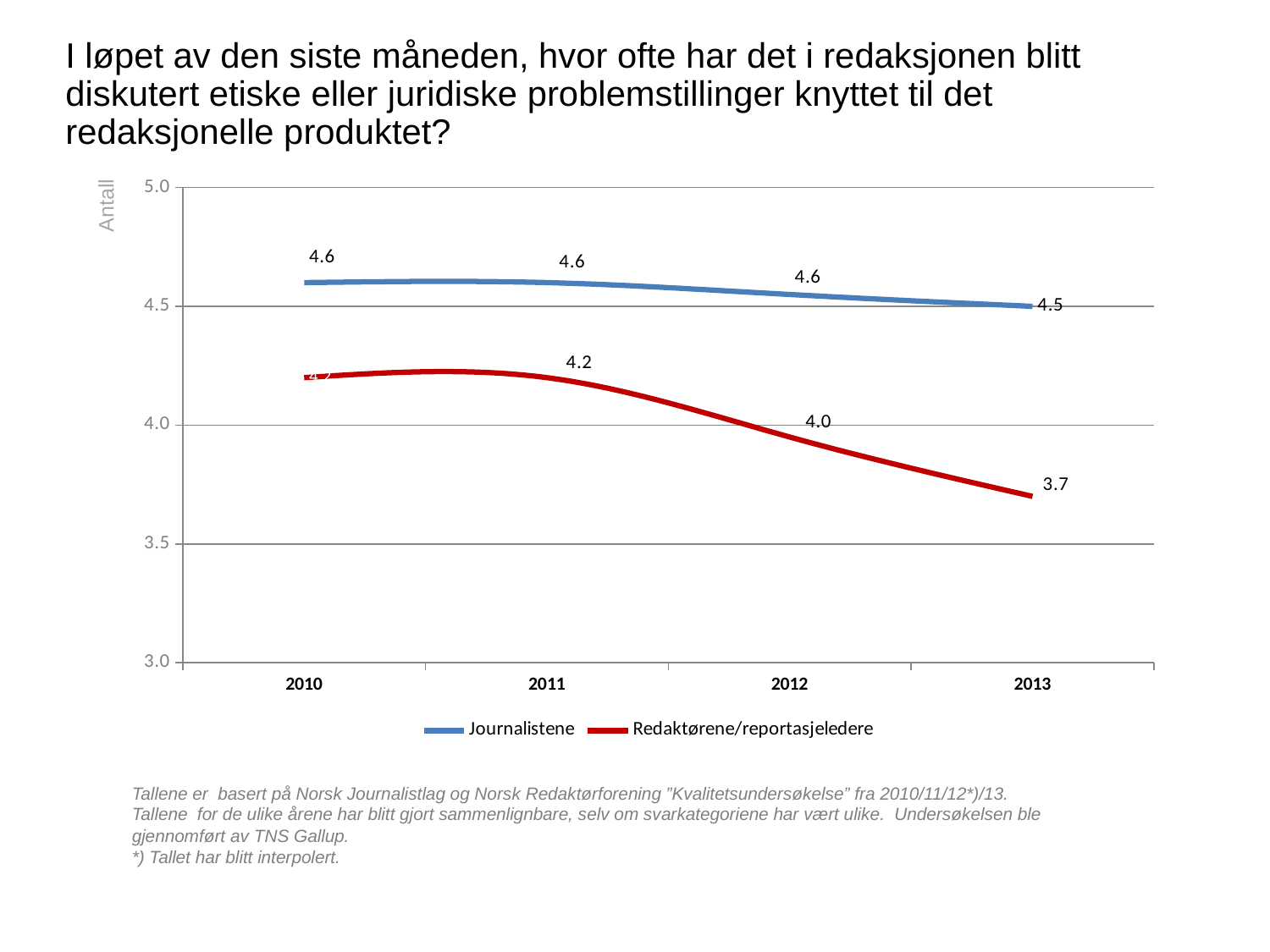
What is the value for Journalistene in 2011? 4.6 Which series has the higher value in 2012, Journalistene or Redaktørene/reportasjeledere? Journalistene What is the value for Journalistene in 2013? 4.5 What type of chart is shown on the slide? line chart How many series does the legend list? 2 Is the value for Redaktørene/reportasjeledere in 2010 greater or less than 4.0? greater What is the difference between Journalistene and Redaktørene/reportasjeledere in 2013? 0.8 What is the value for Redaktørene/reportasjeledere in 2013? 3.7 How many years are shown on the x axis? 4 What is the value for Redaktørene/reportasjeledere in 2012? 4.0 Does the value for Redaktørene/reportasjeledere rise or fall from 2011 to 2013? fall In which year is the value for Redaktørene/reportasjeledere lowest? 2013